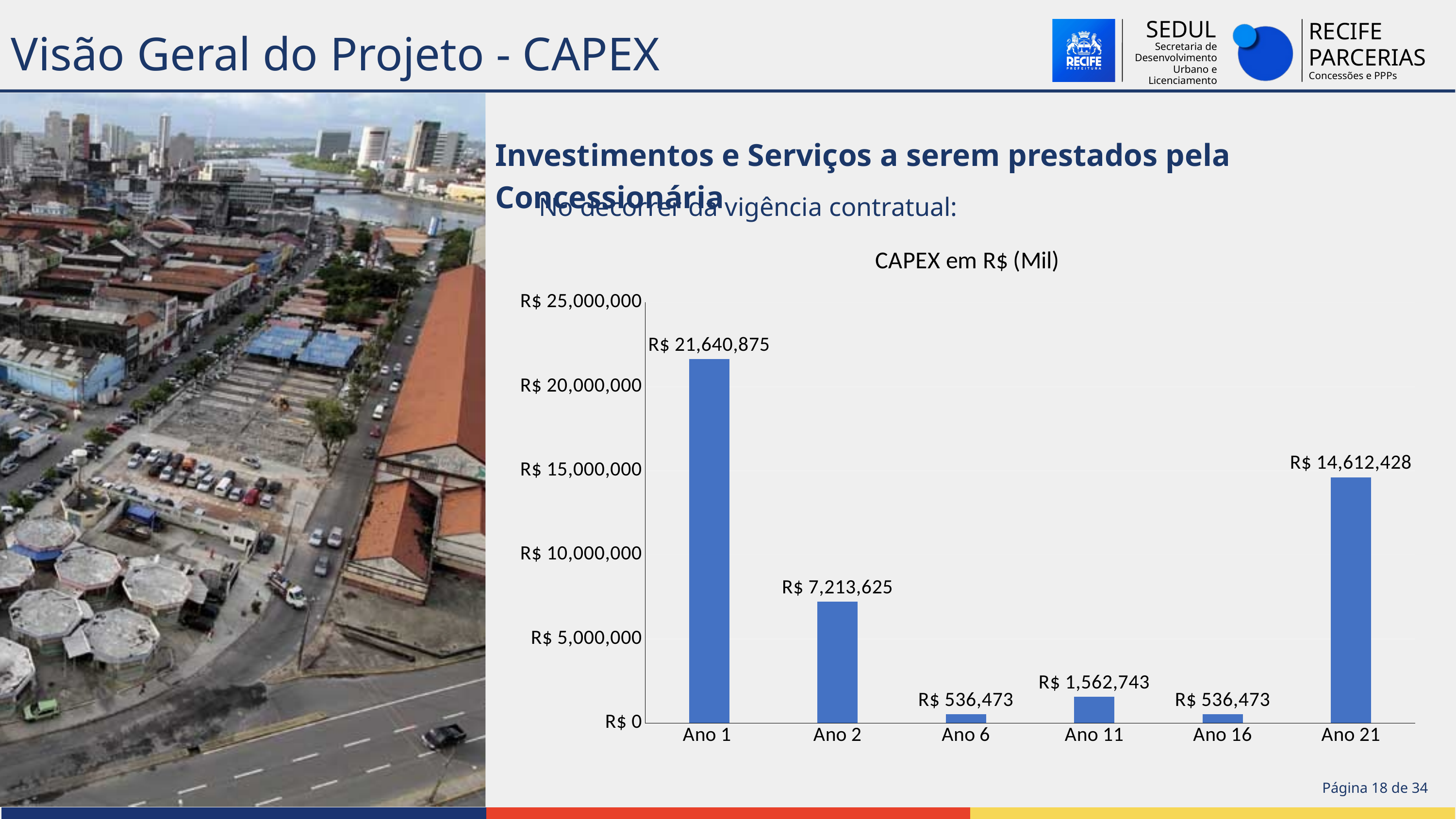
What type of chart is shown on the slide? bar chart What is the CAPEX value for Ano 11? R$ 1,562,743 What is the CAPEX value for Ano 21? R$ 14,612,428 Which year has the highest CAPEX value? Ano 1 What is the title of the chart? CAPEX em R$ (Mil) What is the difference between the CAPEX for Ano 1 and Ano 21? R$ 7,028,447 Is the CAPEX value for Ano 21 greater or less than R$ 10,000,000? greater What is the CAPEX value for Ano 2? R$ 7,213,625 Which is larger, the CAPEX for Ano 2 or for Ano 21? Ano 21 What is the CAPEX value for Ano 1? R$ 21,640,875 How many categories (years) are shown on the x axis of the chart? 6 What is the difference between the CAPEX for Ano 11 and Ano 6? R$ 1,026,270